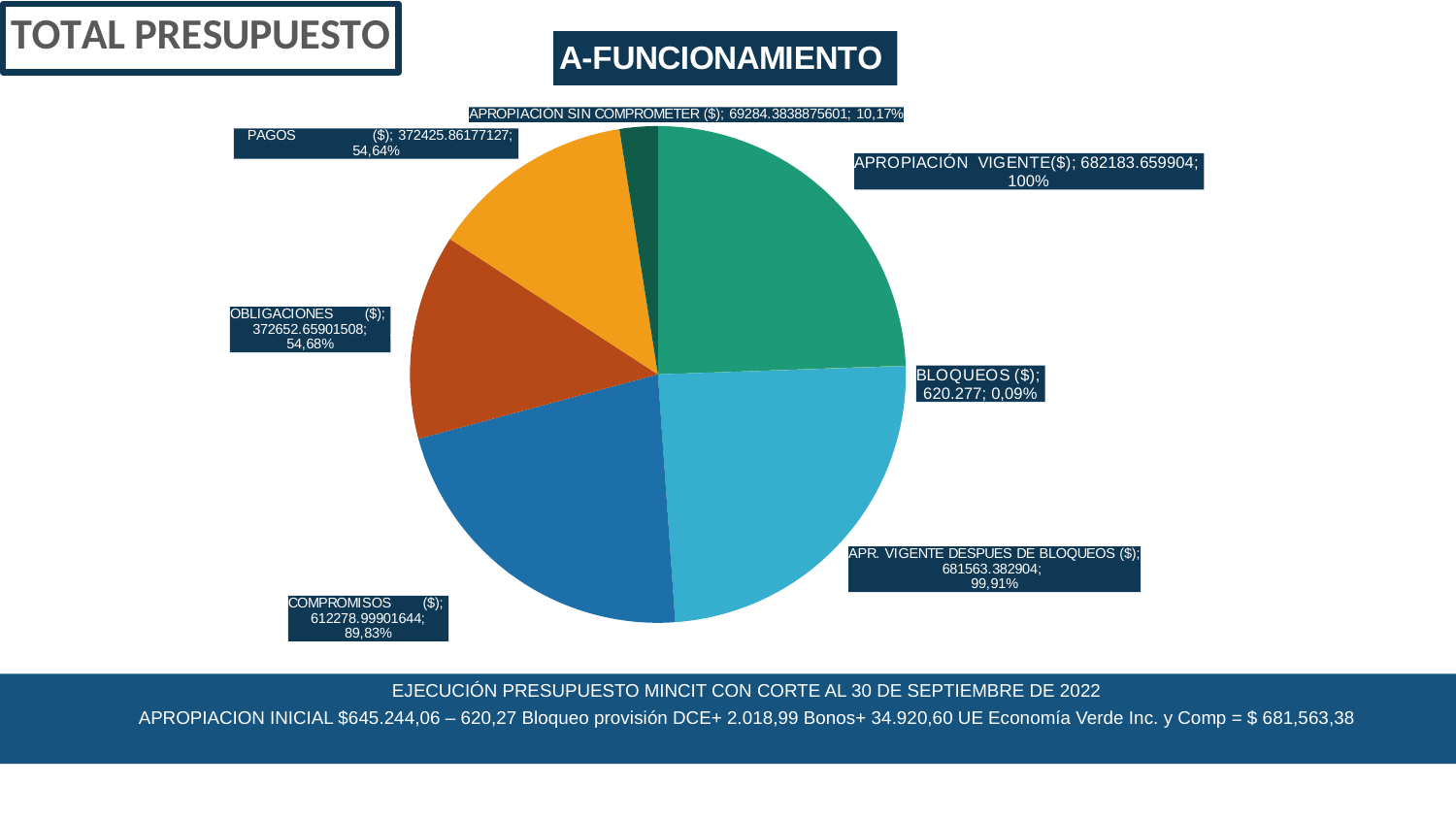
What percentage is printed next to APROPIACIÓN SIN COMPROMETER ($)? 10,17% What value is shown for COMPROMISOS ($)? 612278.99901644 How many slices does the pie chart have? 7 What value is shown for BLOQUEOS ($)? 620.277 Which is larger, the value for OBLIGACIONES ($) or the value for PAGOS ($)? OBLIGACIONES ($) What percentage is printed next to APR. VIGENTE DESPUES DE BLOQUEOS ($)? 99,91% Which category has the largest value? APROPIACIÓN VIGENTE($) What value is shown for APROPIACIÓN VIGENTE($)? 682183.659904 What is the difference between the value for APROPIACIÓN VIGENTE($) and the value for APR. VIGENTE DESPUES DE BLOQUEOS ($)? 620.277 Which category has the smallest value? BLOQUEOS ($) What type of chart is shown on the slide? Pie chart